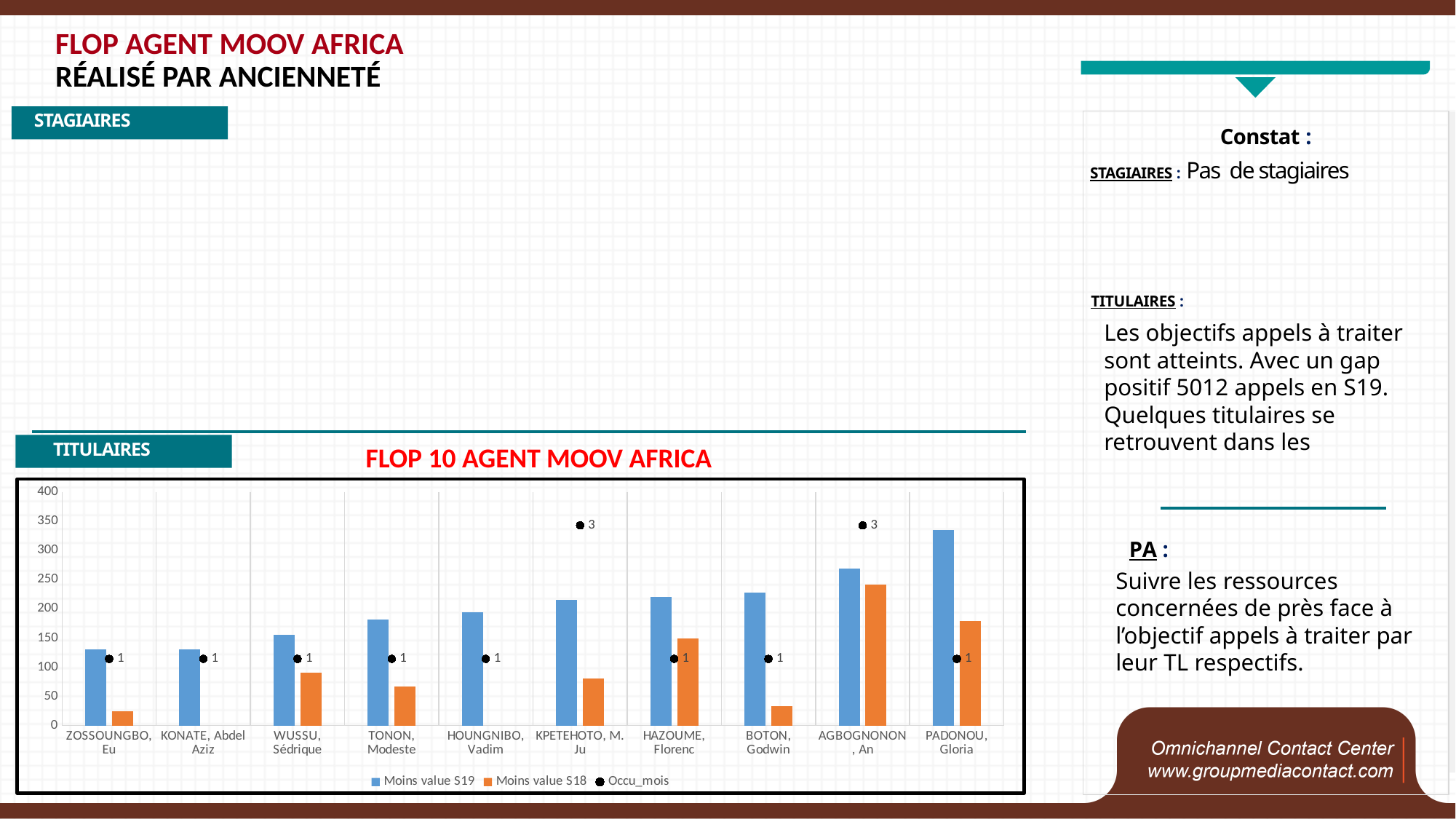
What is the Occu_mois value shown for TONON, Modeste? 1 Is the Moins value S18 for ZOSSOUNGBO, Eu greater or less than 50? less How many agents (categories) are shown on the x axis of the FLOP 10 AGENT MOOV AFRICA chart? 10 What kind of chart is the FLOP 10 AGENT MOOV AFRICA chart? bar chart What is the Occu_mois value shown for AGBOGNONON, An? 3 Which agent has the highest Moins value S19 bar? PADONOU, Gloria Which agent has the highest Moins value S18 bar? AGBOGNONON, An For PADONOU, Gloria, which is larger: Moins value S19 or Moins value S18? Moins value S19 Is the Moins value S19 for PADONOU, Gloria greater or less than 300? greater How many series does the legend of the FLOP 10 AGENT MOOV AFRICA chart list? 3 Do the Moins value S19 bars generally rise or fall from left to right across the agents? rise What is the Occu_mois value shown for KPETEHOTO, M. Ju? 3